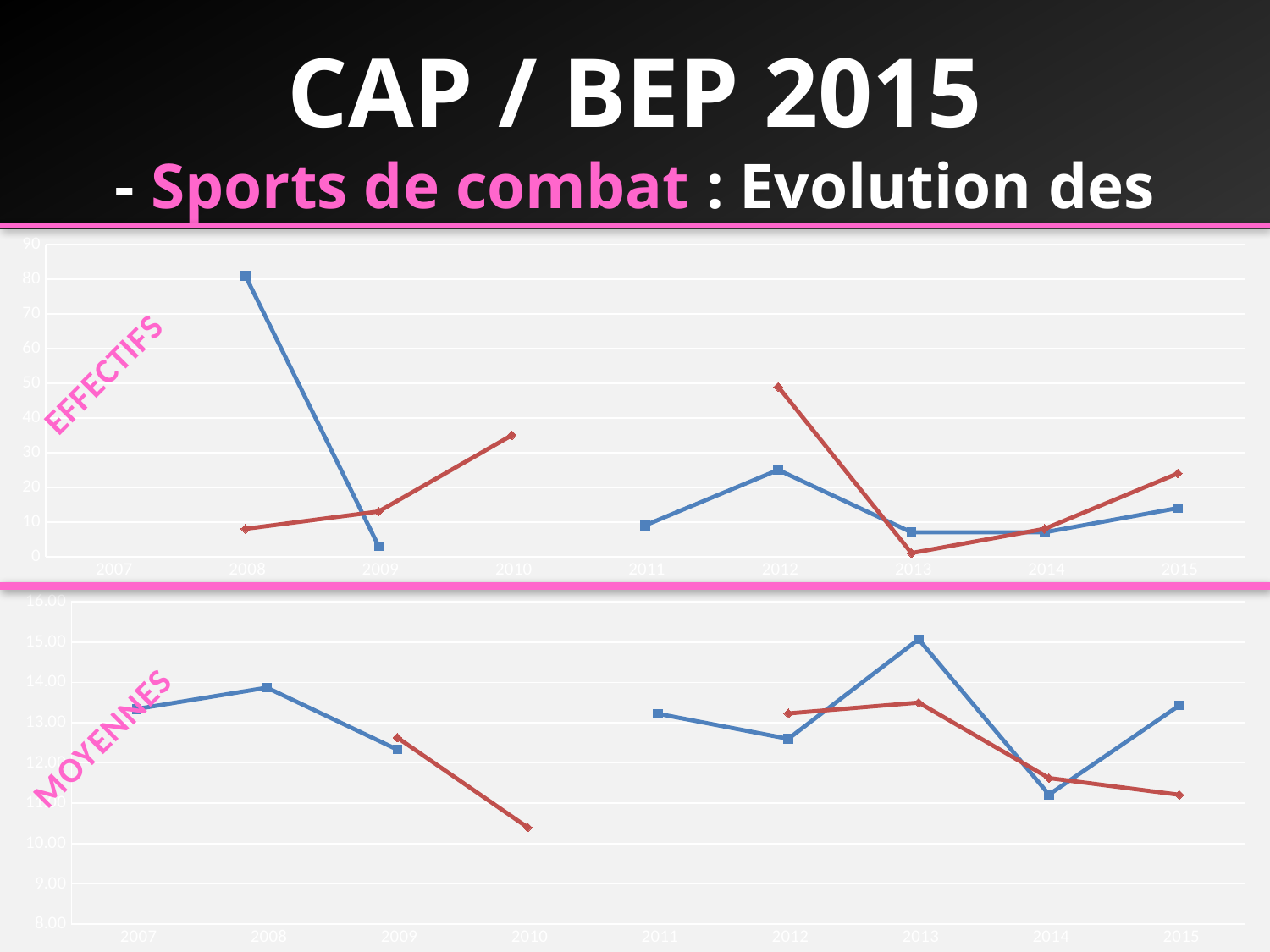
In the bottom chart (MOYENNES), is the value of the blue series in 2013 greater or less than 14.00? greater In the bottom chart (MOYENNES), in which year does the blue series reach its highest value? 2013 How many years are shown on the x axis of the top chart (EFFECTIFS)? 9 In the bottom chart (MOYENNES), does the blue series rise or fall from 2013 to 2014? fall In the bottom chart (MOYENNES), in which year does the red series reach its lowest value? 2010 In the top chart (EFFECTIFS), in which year does the blue series reach its highest value? 2008 In the top chart (EFFECTIFS), is the value of the blue series in 2008 greater or less than 70? greater In the top chart (EFFECTIFS), which series has the larger value in 2012, the blue or the red? red In the top chart (EFFECTIFS), is the value of the blue series in 2009 greater or less than 10? less What kind of chart is the top chart labelled EFFECTIFS? line chart What kind of chart is the bottom chart labelled MOYENNES? line chart In the top chart (EFFECTIFS), in which year does the red series reach its highest value? 2012